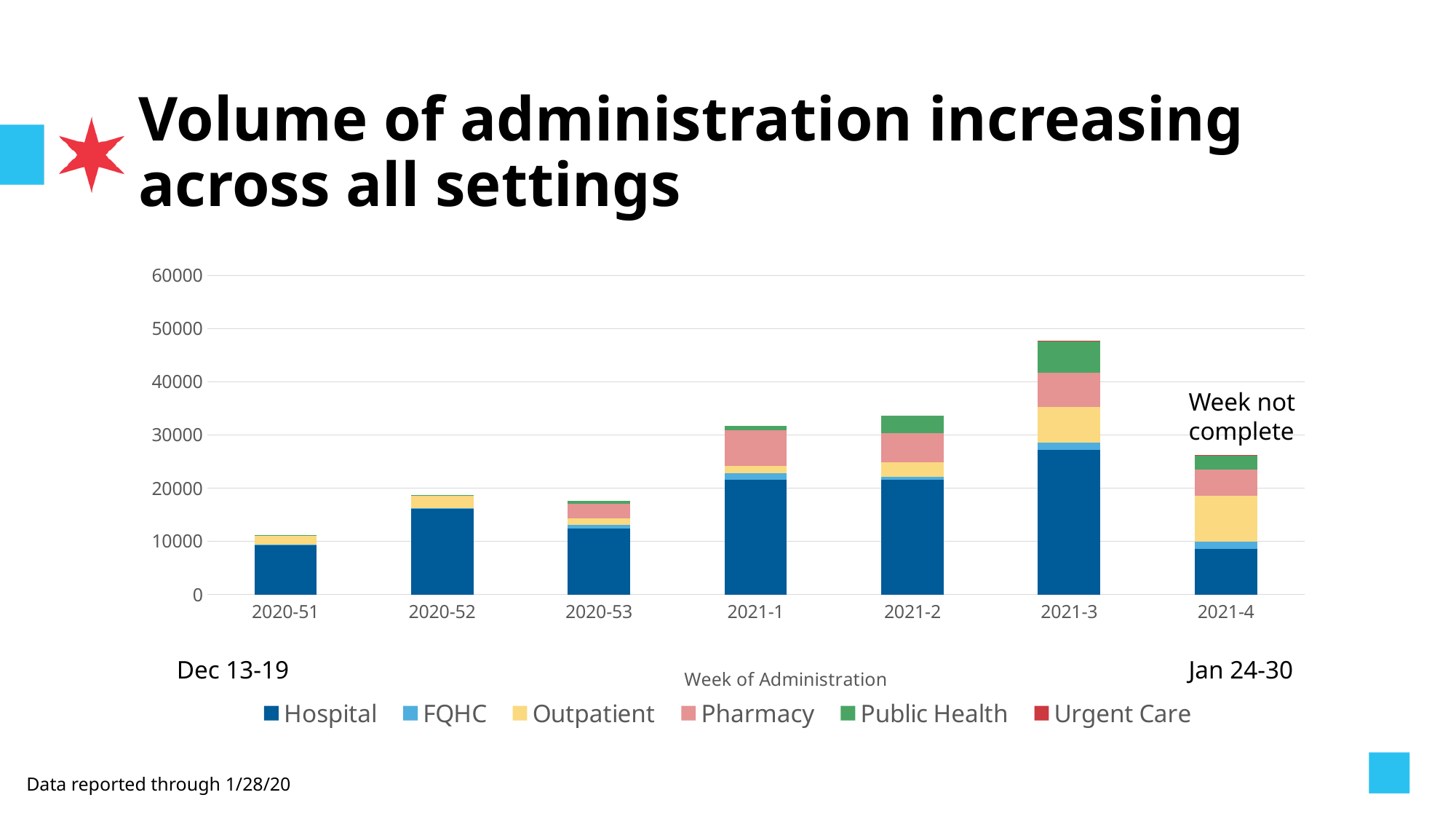
How many weeks (categories) are shown on the x axis? 7 What is the title of the x axis? Week of Administration How many series does the legend list? 6 Is the total for week 2021-4 greater or less than 30000? less Which week has the shortest stacked bar (lowest total volume)? 2020-51 What kind of chart is shown on the slide? Stacked bar chart Which week has the larger total volume, 2021-2 or 2021-3? 2021-3 Which week has the tallest stacked bar (highest total volume)? 2021-3 Is the Hospital segment for week 2021-3 greater or less than 20000? greater Is the total for week 2021-3 greater or less than 40000? greater From week 2020-51 to week 2021-3, do the total volumes generally rise or fall? rise